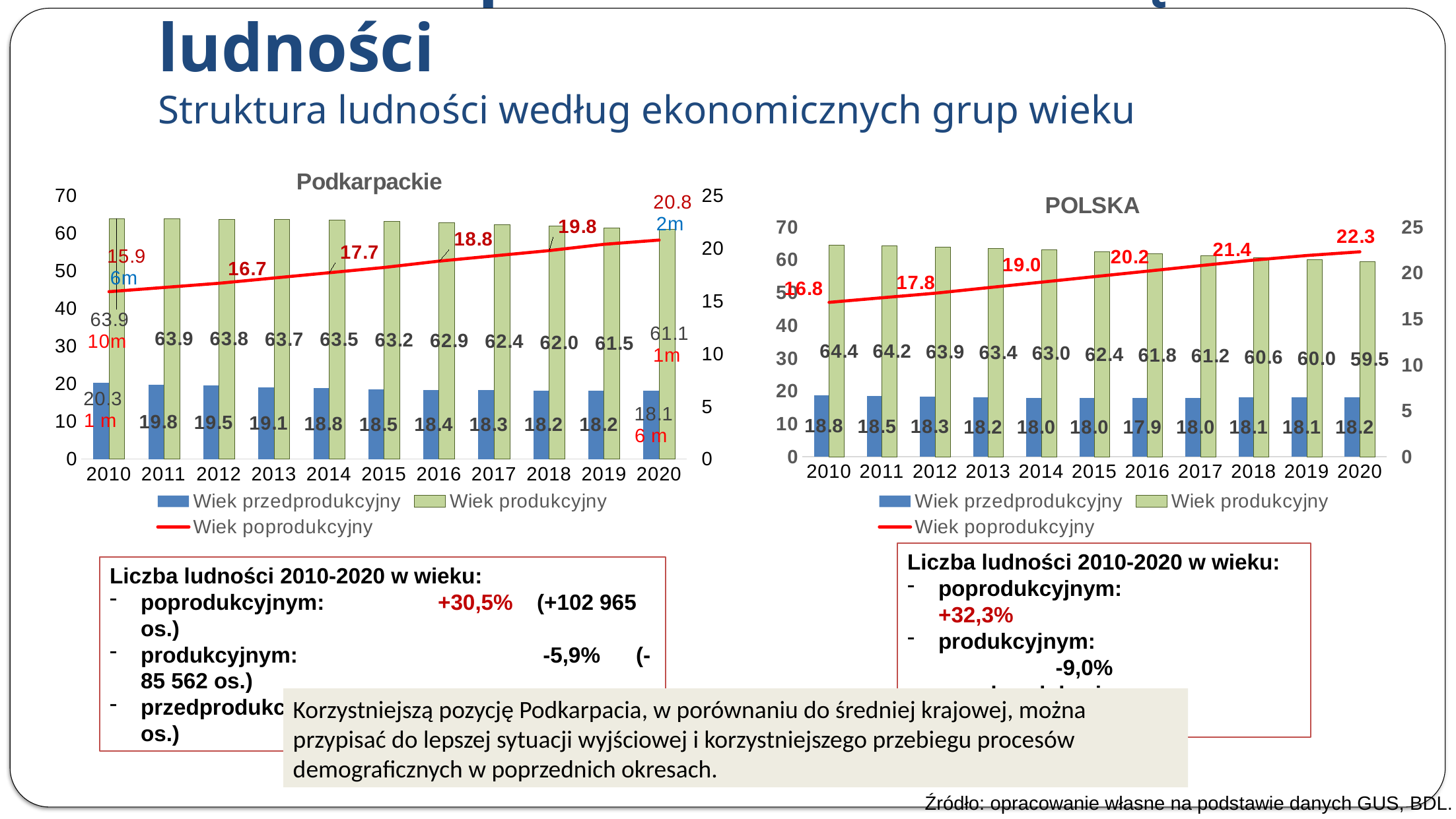
In the Podkarpackie chart, which is larger: Wiek produkcyjny in 2015 or Wiek produkcyjny in 2019? 2015 How many series does the legend of the POLSKA chart list? 3 In the Podkarpackie chart, which year has the highest value for Wiek przedprodukcyjny? 2010 In the POLSKA chart, what is the value of the Wiek poprodukcyjny line in 2014? 19.0 In the POLSKA chart, what is the difference between the Wiek produkcyjny values for 2010 and 2020? 4.9 How many years are shown on the x axis of the Podkarpackie chart? 11 In the POLSKA chart, which year has the lowest value for Wiek produkcyjny? 2020 In the Podkarpackie chart, what is the difference between the Wiek przedprodukcyjny values for 2010 and 2020? 2.2 In the POLSKA chart, what is the value for Wiek przedprodukcyjny in 2016? 17.9 In the POLSKA chart, does the Wiek produkcyjny series rise or fall from 2010 to 2020? fall In the Podkarpackie chart, what is the value for Wiek produkcyjny in 2010? 63.9 In the Podkarpackie chart, what is the value of the Wiek poprodukcyjny line in 2020? 20.8